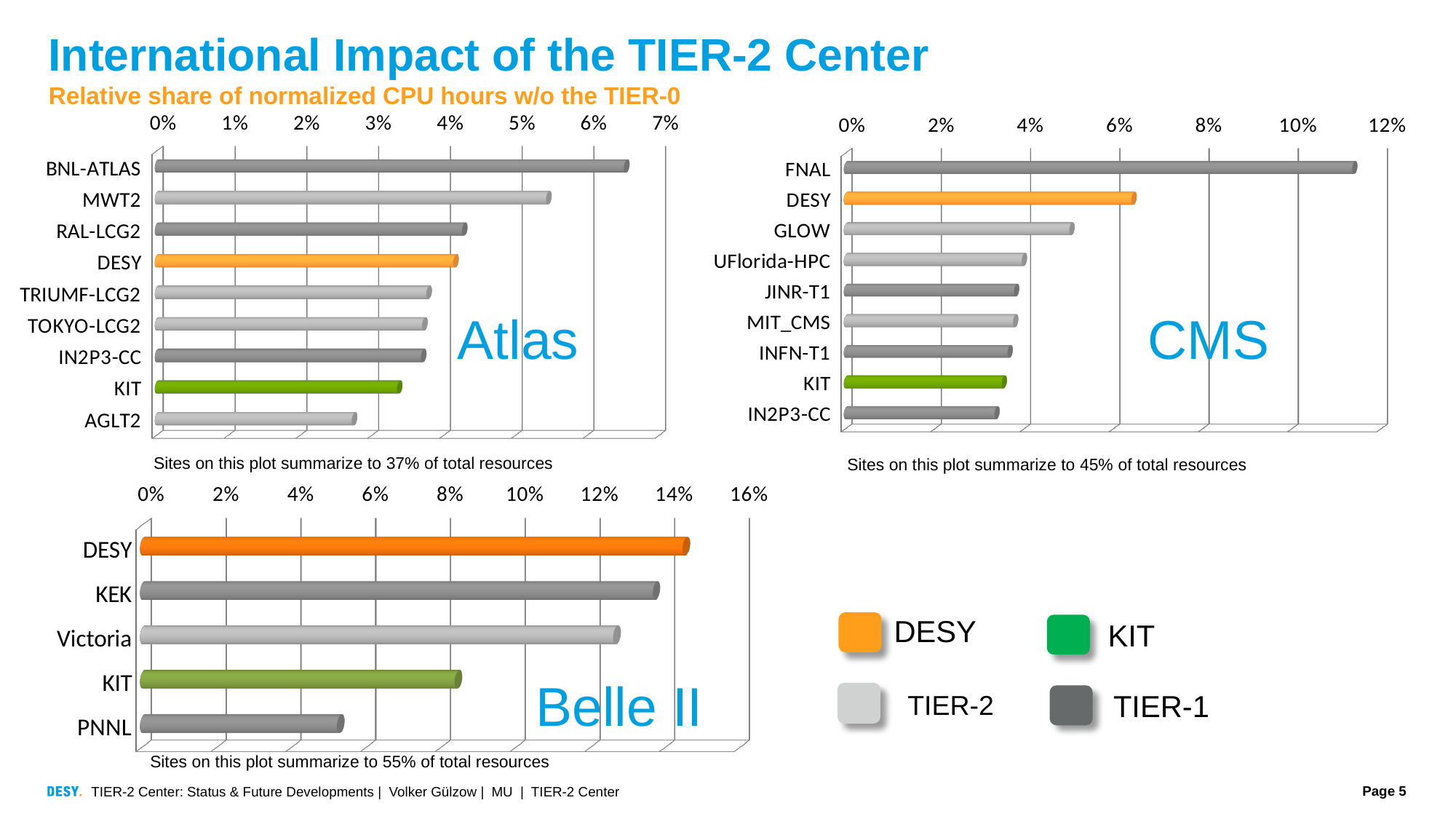
In the Atlas chart, is the value for BNL-ATLAS greater or less than 6%? greater In the Belle II chart, is the value for KIT greater or less than 10%? less In the CMS chart, is the value for FNAL greater or less than 10%? greater How many sites are shown in the Atlas chart? 9 What type of chart is the Belle II chart? bar chart In the CMS chart, which has the larger share, DESY or GLOW? DESY In the Atlas chart, which site has the highest relative share of normalized CPU hours? BNL-ATLAS In the Atlas chart, which has the larger share, MWT2 or RAL-LCG2? MWT2 In the Belle II chart, which site has the lowest relative share? PNNL In the CMS chart, which site has the highest relative share? FNAL In the Atlas chart, which site has the lowest relative share? AGLT2